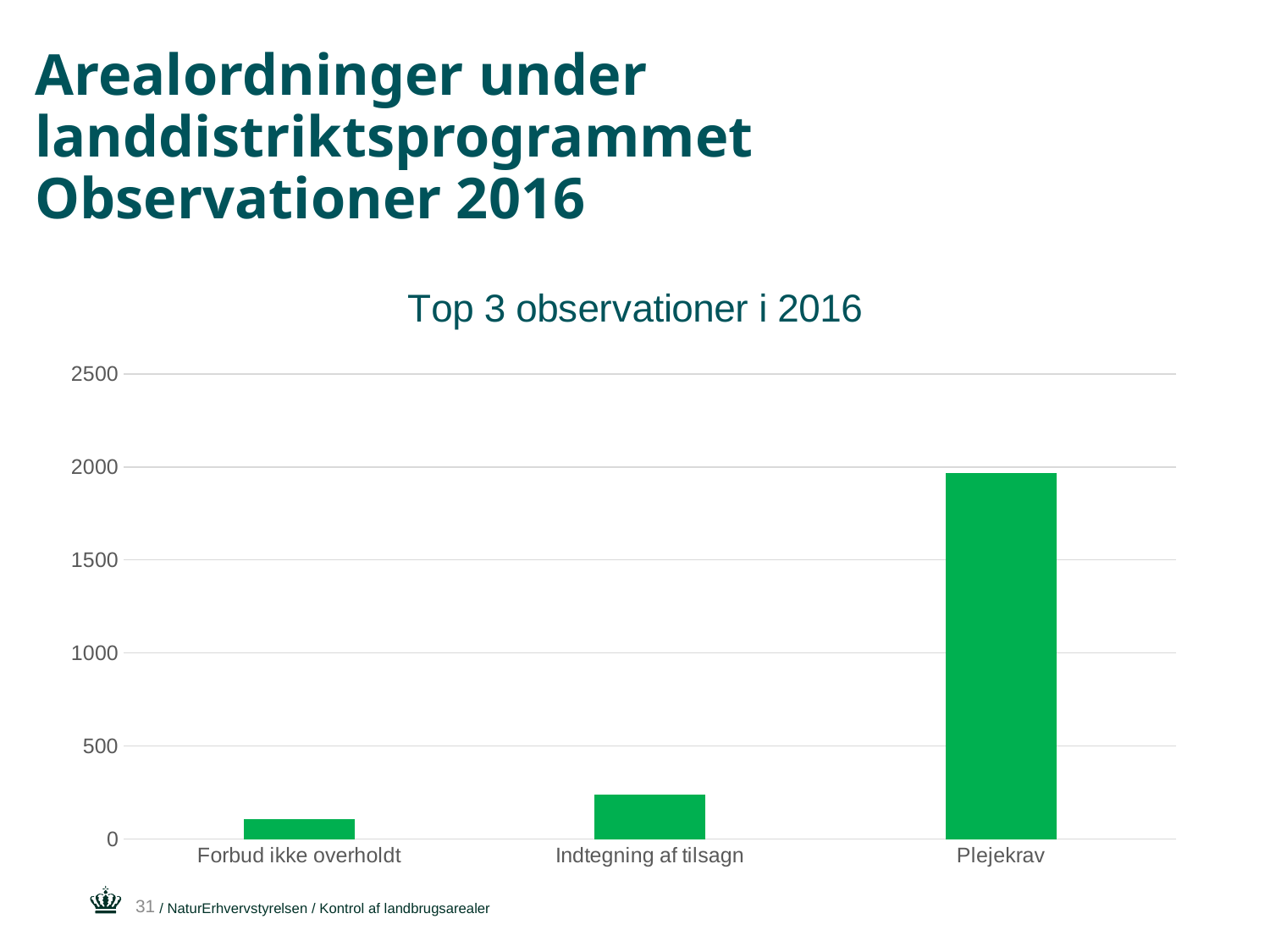
Do the values rise or fall from left to right along the x axis? rise What is the highest value shown on the vertical axis? 2500 Is the value for Indtegning af tilsagn greater or less than 500? less Is the value for Forbud ikke overholdt greater or less than 500? less Which category has the lowest value? Forbud ikke overholdt How many categories are shown on the x axis of the chart? 3 What is the title of the chart? Top 3 observationer i 2016 Is the value for Plejekrav greater or less than 2000? less Which is larger, the value for Indtegning af tilsagn or the value for Forbud ikke overholdt? Indtegning af tilsagn What kind of chart is shown on the slide? Bar chart Which category has the highest value? Plejekrav